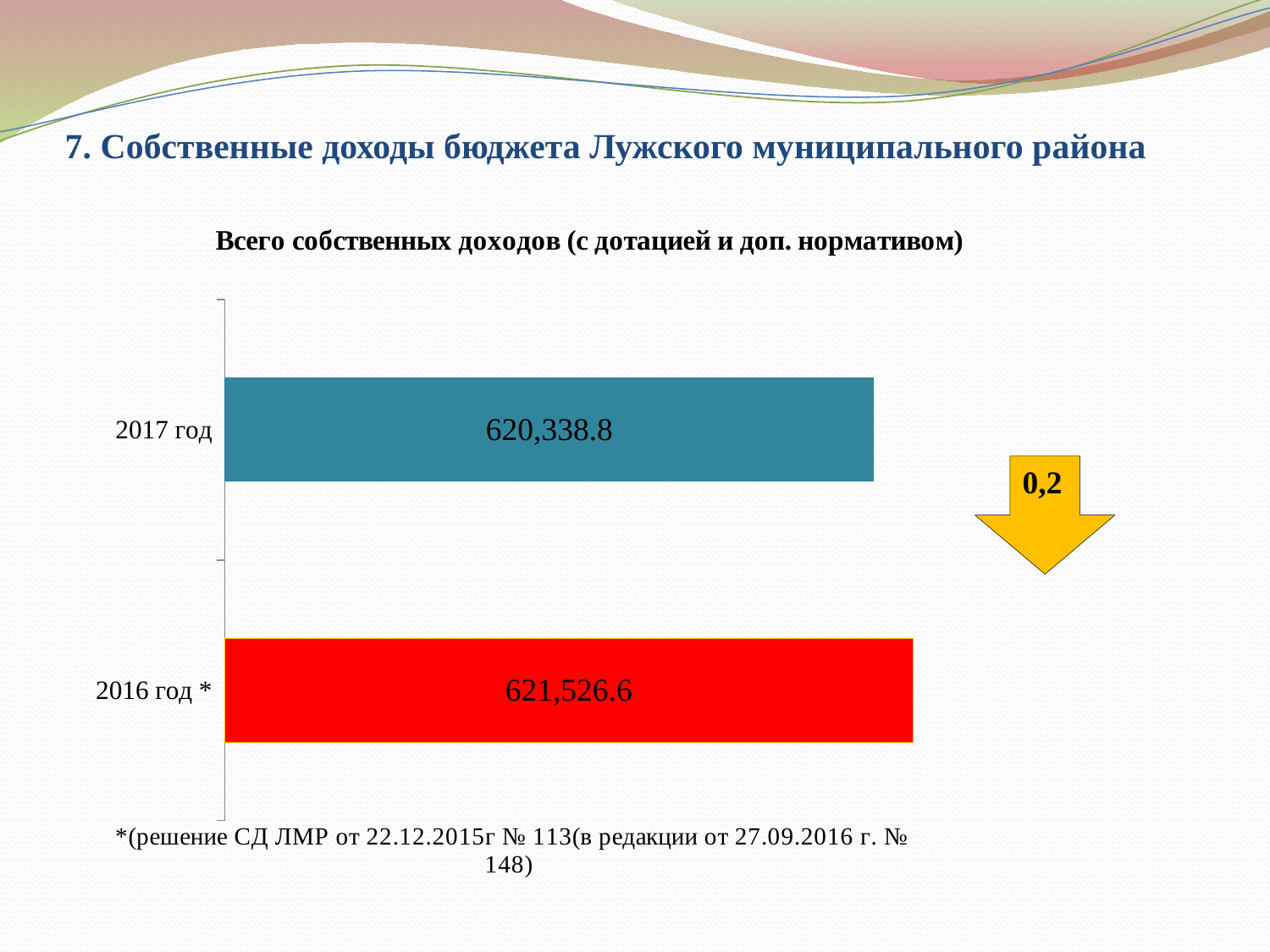
What number is shown on the yellow arrow next to the chart? 0,2 What is the value for 2017 год? 620,338.8 Which year has the lower value? 2017 год Which year has the higher value? 2016 год * How many categories (bars) are shown in the chart? 2 What kind of chart is shown on the slide? bar chart Is the value for 2017 год larger or smaller than the value for 2016 год *? smaller What is the value for 2016 год *? 621,526.6 Does the value decrease or increase from 2016 год * to 2017 год? decrease What is the title of the chart? Всего собственных доходов (с дотацией и доп. нормативом) What is the difference between the values for 2016 год * and 2017 год? 1,187.8